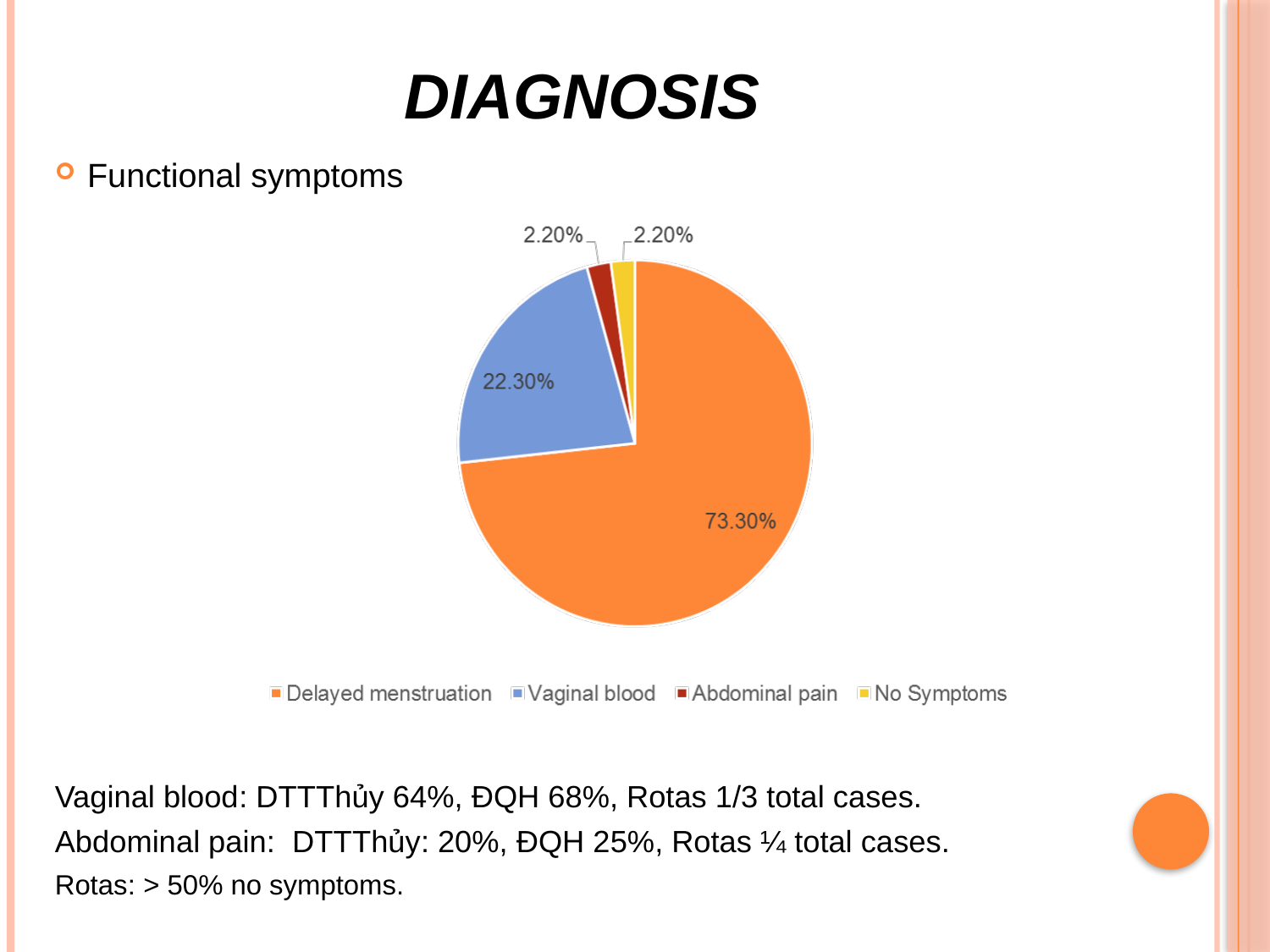
How many slices does the pie chart have? 4 What percentage of the pie is labelled for Vaginal blood? 22.30% What percentage of the pie is labelled for No Symptoms? 2.20% What is the difference in percentage points between the Delayed menstruation slice and the Vaginal blood slice? 51.00 percentage points What percentage of the pie is labelled for Abdominal pain? 2.20% What colour is the slice for No Symptoms? Yellow What kind of chart is shown on the slide? Pie chart What percentage of the pie is labelled for Delayed menstruation? 73.30% How many entries does the legend list? 4 What colour is the slice for Vaginal blood? Blue Which category has the largest slice of the pie? Delayed menstruation Which is larger, the slice for Vaginal blood or the slice for Abdominal pain? Vaginal blood